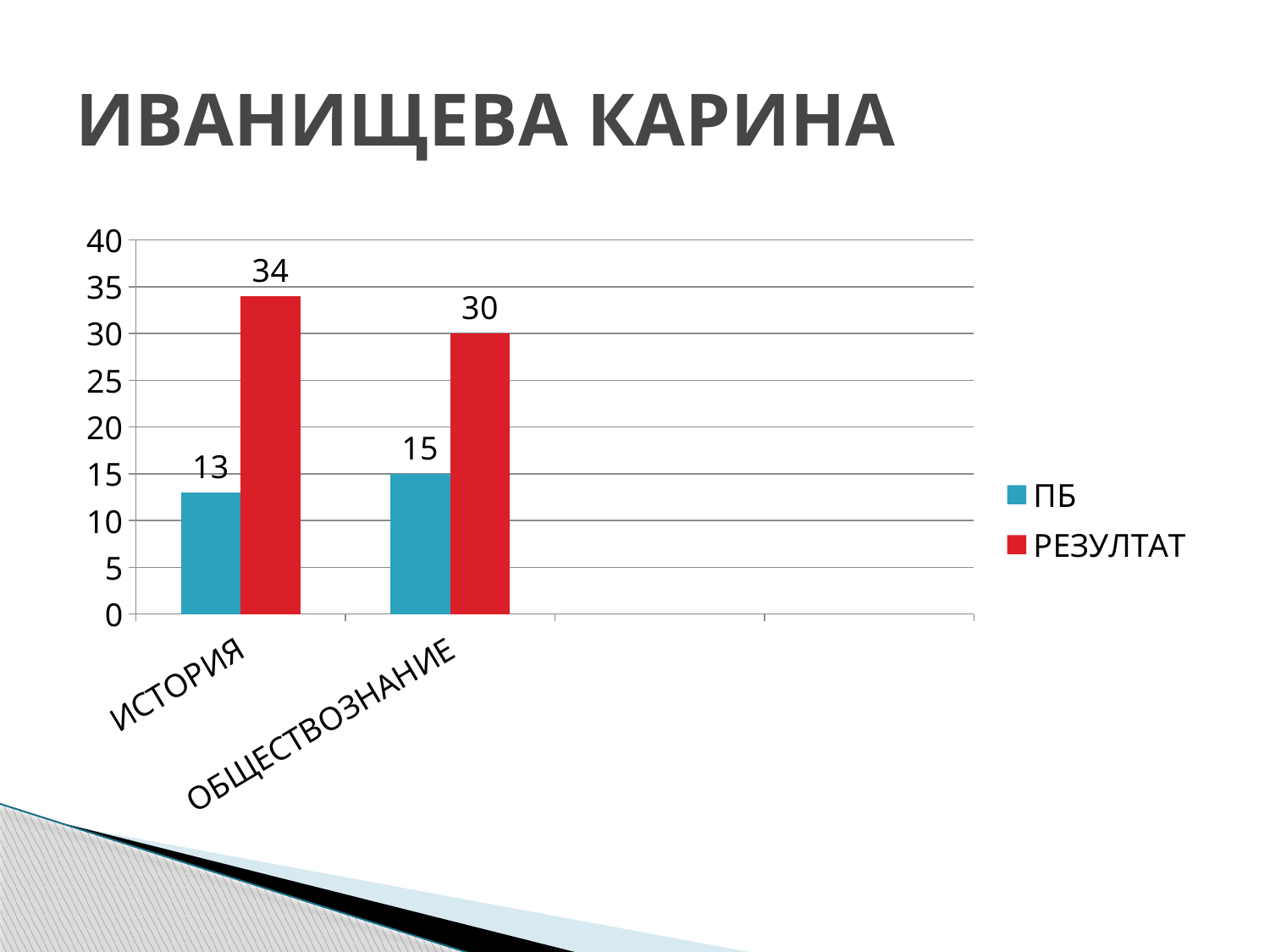
Which category has the lowest ПБ value? ИСТОРИЯ How many series does the legend list? 2 What is the РЕЗУЛТАТ value for ОБЩЕСТВОЗНАНИЕ? 30 What is the ПБ value for ОБЩЕСТВОЗНАНИЕ? 15 What is the РЕЗУЛТАТ value for ИСТОРИЯ? 34 What is the ПБ value for ИСТОРИЯ? 13 How many categories are shown on the x axis? 2 What is the difference between the РЕЗУЛТАТ values for ИСТОРИЯ and ОБЩЕСТВОЗНАНИЕ? 4 Which category has the highest РЕЗУЛТАТ value? ИСТОРИЯ What is the difference between the РЕЗУЛТАТ and ПБ values for ИСТОРИЯ? 21 What kind of chart is shown on the slide? bar chart Which is larger: the ПБ value for ИСТОРИЯ or the ПБ value for ОБЩЕСТВОЗНАНИЕ? ОБЩЕСТВОЗНАНИЕ